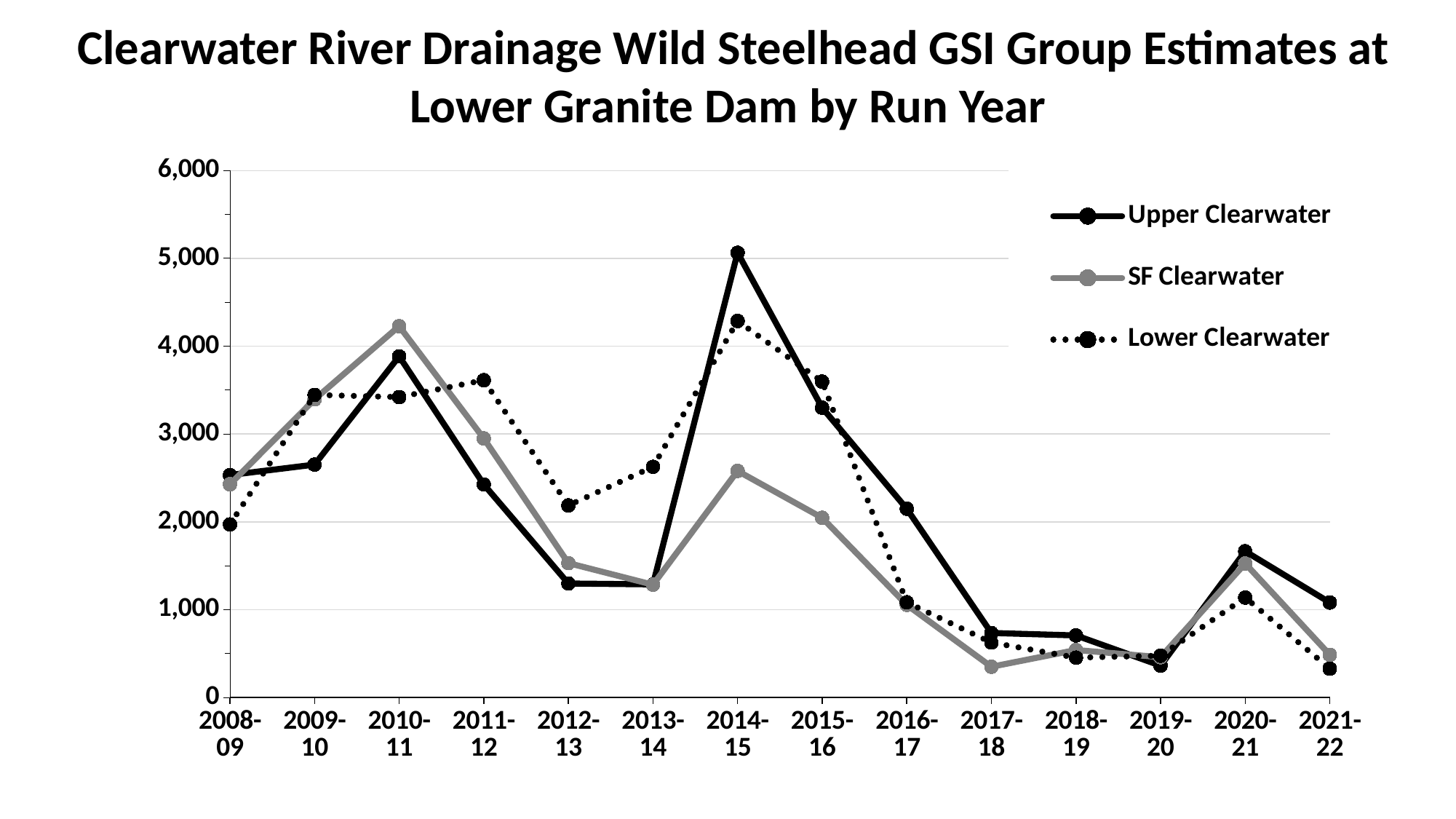
In which run year does the Upper Clearwater series reach its highest value? 2014-15 How many run years are plotted along the x axis? 14 How many series does the legend list? 3 Is the Lower Clearwater value for 2011-12 greater or less than 3,000? greater Does the Upper Clearwater series rise or fall from 2014-15 to 2019-20? Fall Which series is drawn with a dotted line? Lower Clearwater In which run year does the Upper Clearwater series reach its lowest value? 2019-20 Is the SF Clearwater value for 2017-18 greater or less than 1,000? less In which run year does the SF Clearwater series reach its highest value? 2010-11 What kind of chart is shown on the slide? Line chart In 2014-15, which is larger: Upper Clearwater or SF Clearwater? Upper Clearwater Is the Upper Clearwater value for 2014-15 greater or less than 4,000? greater